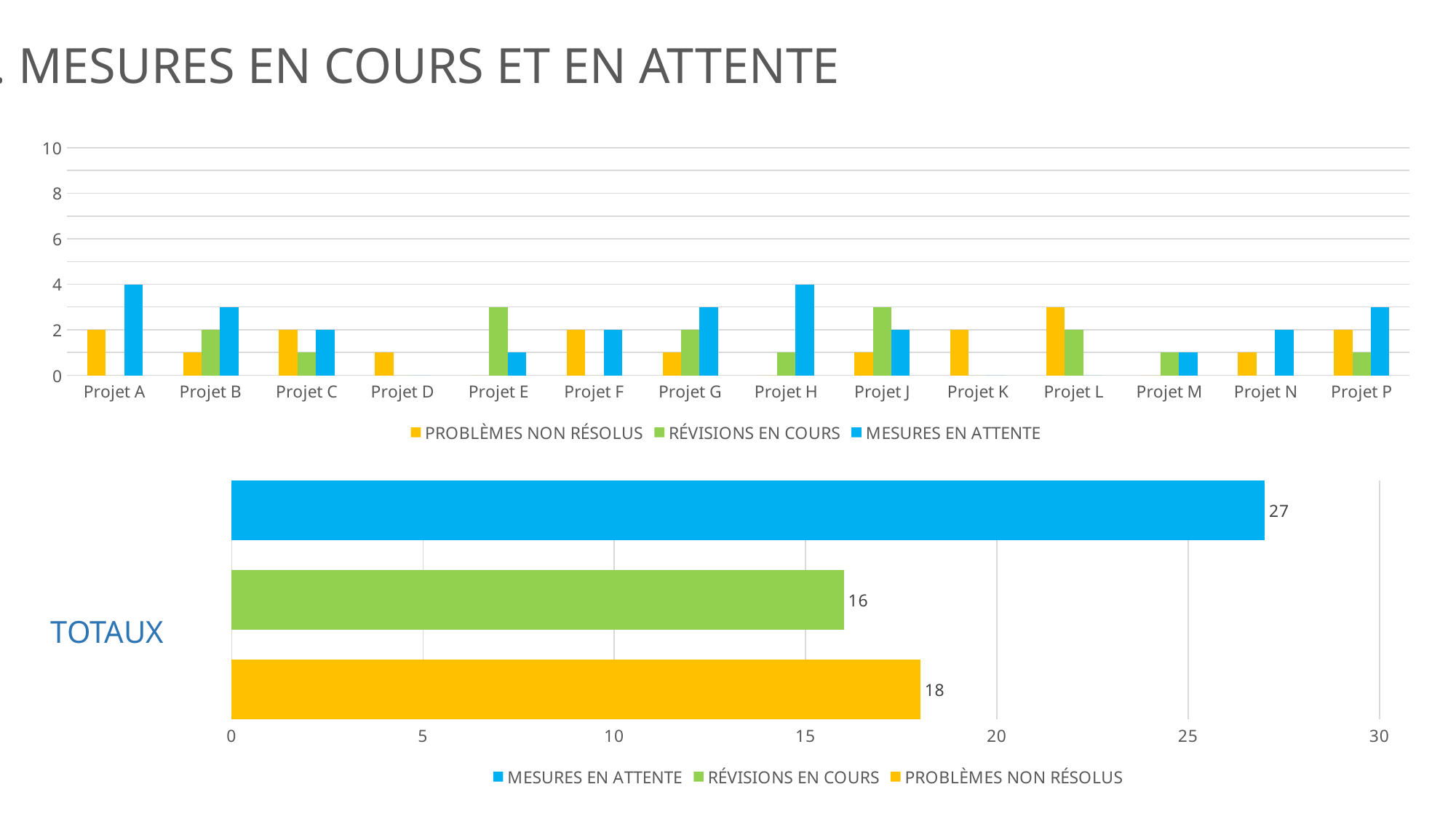
In the top chart, is the value of MESURES EN ATTENTE for Projet H greater or less than 2? greater In the top chart, what is the value of MESURES EN ATTENTE for Projet A? 4 In the bottom chart (TOTAUX), which category has the highest value? MESURES EN ATTENTE In the top chart, what is the value of PROBLÈMES NON RÉSOLUS for Projet C? 2 In the bottom chart (TOTAUX), what is the value for MESURES EN ATTENTE? 27 In the bottom chart (TOTAUX), which category has the lowest value? RÉVISIONS EN COURS What kind of chart is the bottom chart (TOTAUX)? Bar chart In the top chart, which project has the larger MESURES EN ATTENTE value, Projet A or Projet B? Projet A In the bottom chart (TOTAUX), what is the difference between MESURES EN ATTENTE and PROBLÈMES NON RÉSOLUS? 9 In the bottom chart (TOTAUX), what is the value for RÉVISIONS EN COURS? 16 In the top chart, how many series does the legend list? 3 In the top chart, how many projects are shown on the x axis? 14